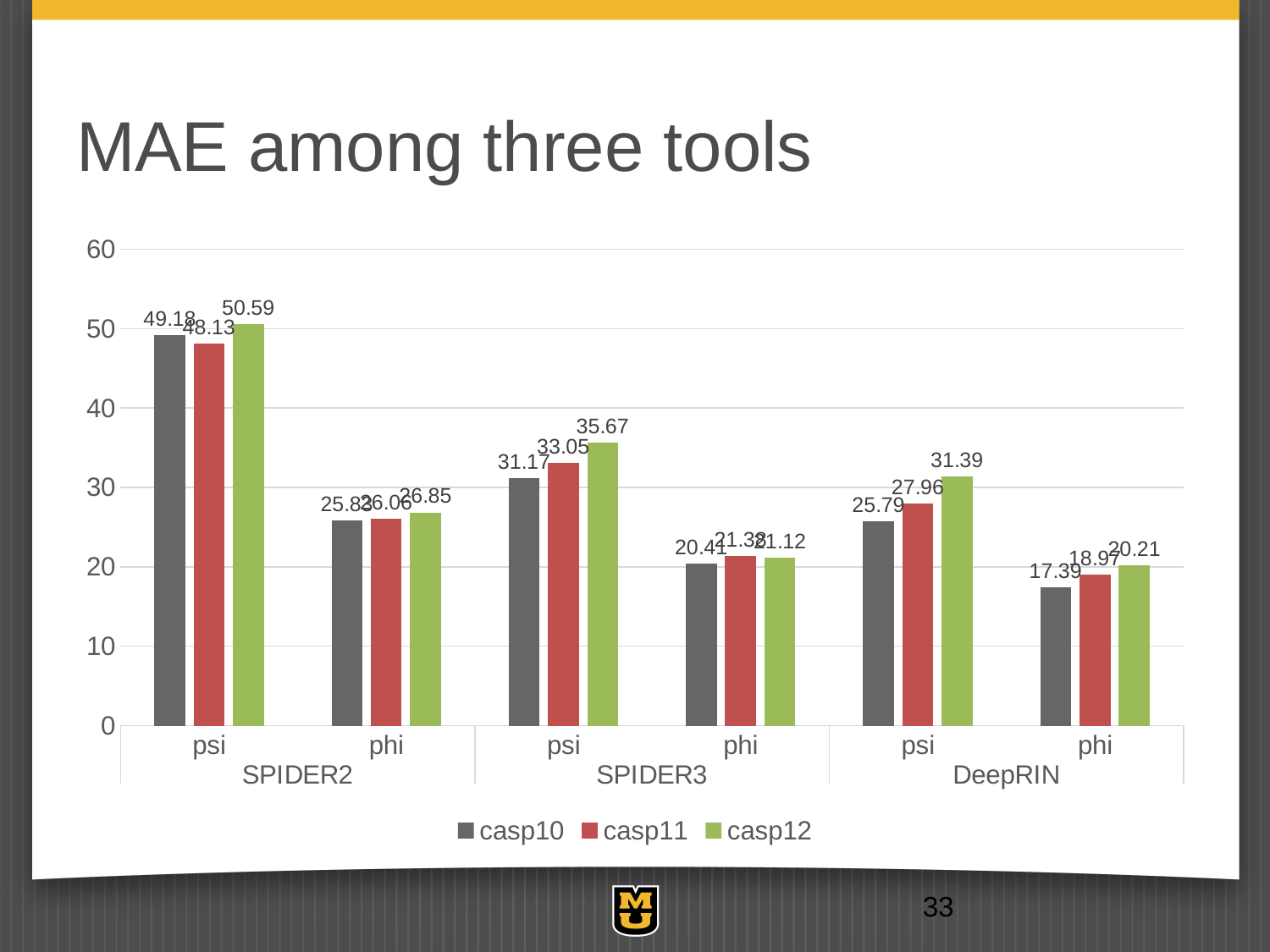
For psi under SPIDER2, which is larger: the casp10 value or the casp11 value? casp10 Which bar has the lowest value on the whole chart? casp10 for phi under DeepRIN (17.39) What kind of chart is shown on the slide? bar chart For psi under SPIDER3, which series has the highest value? casp12 Is the casp10 value for phi under DeepRIN greater or less than 20? less What is the casp12 value for psi under DeepRIN? 31.39 What is the casp10 value for phi under DeepRIN? 17.39 For psi under DeepRIN, do the values rise or fall from casp10 to casp12? rise What is the difference between the casp12 and casp10 values for psi under SPIDER3? 4.5 How many series does the legend list? 3 What is the casp12 value for psi under SPIDER2? 50.59 What is the casp10 value for psi under SPIDER3? 31.17